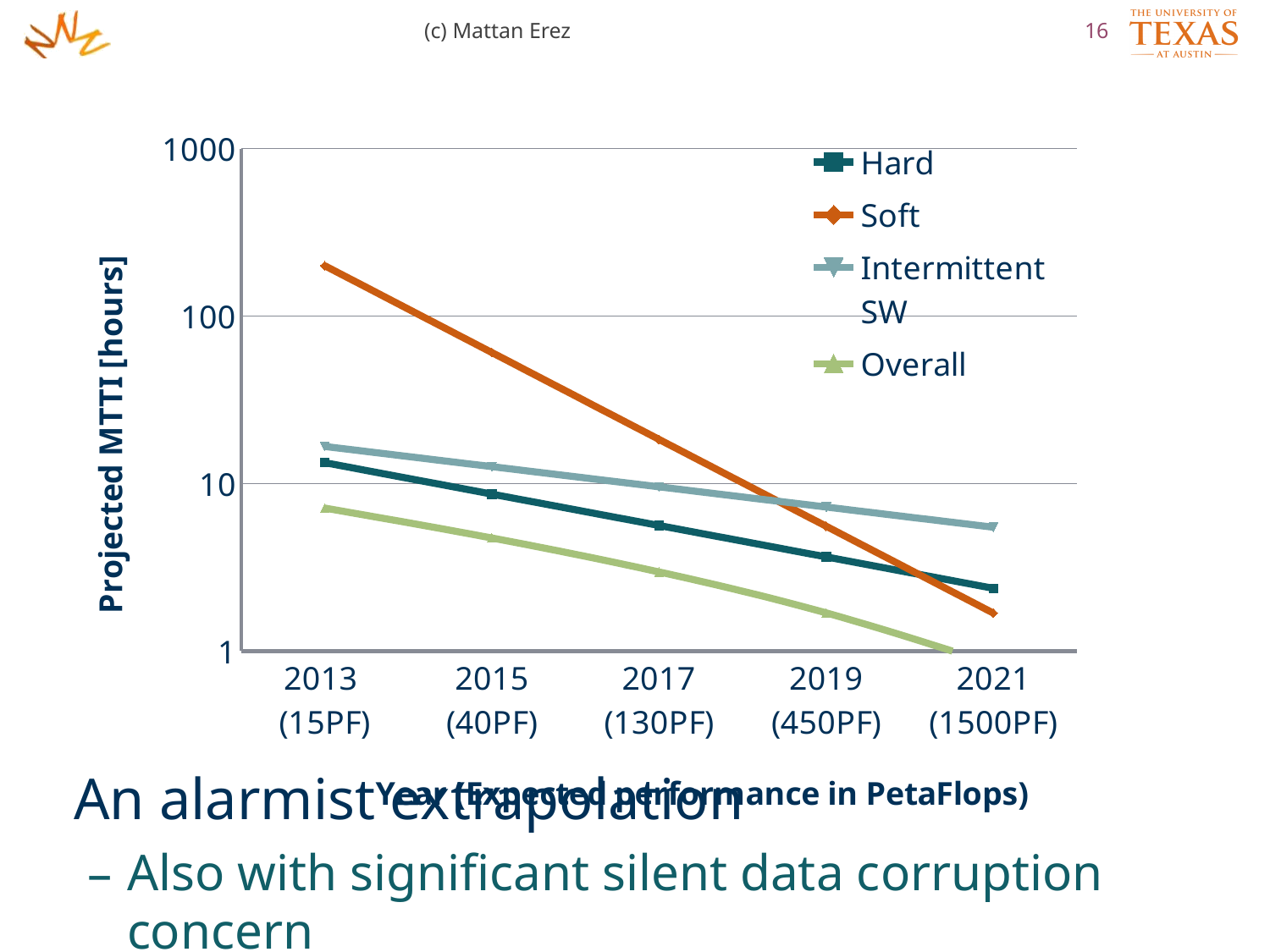
How many years are plotted along the x axis of the chart? 5 What kind of chart is shown on the slide? line chart Which series has the lowest projected MTTI in 2013? Overall In 2021, which is larger: the value for Intermittent SW or the value for Soft? Intermittent SW What is the label on the y axis of the chart? Projected MTTI [hours] How many series does the chart legend list? 4 Which series has the lowest projected MTTI in 2021? Overall Do the values for the Soft series rise or fall from 2013 to 2021? fall Which series has the highest projected MTTI in 2013? Soft Is the value for Hard in 2013 greater or less than 10? greater Is the value for Soft in 2013 greater or less than 100? greater Is the value for Soft in 2021 greater or less than 10? less